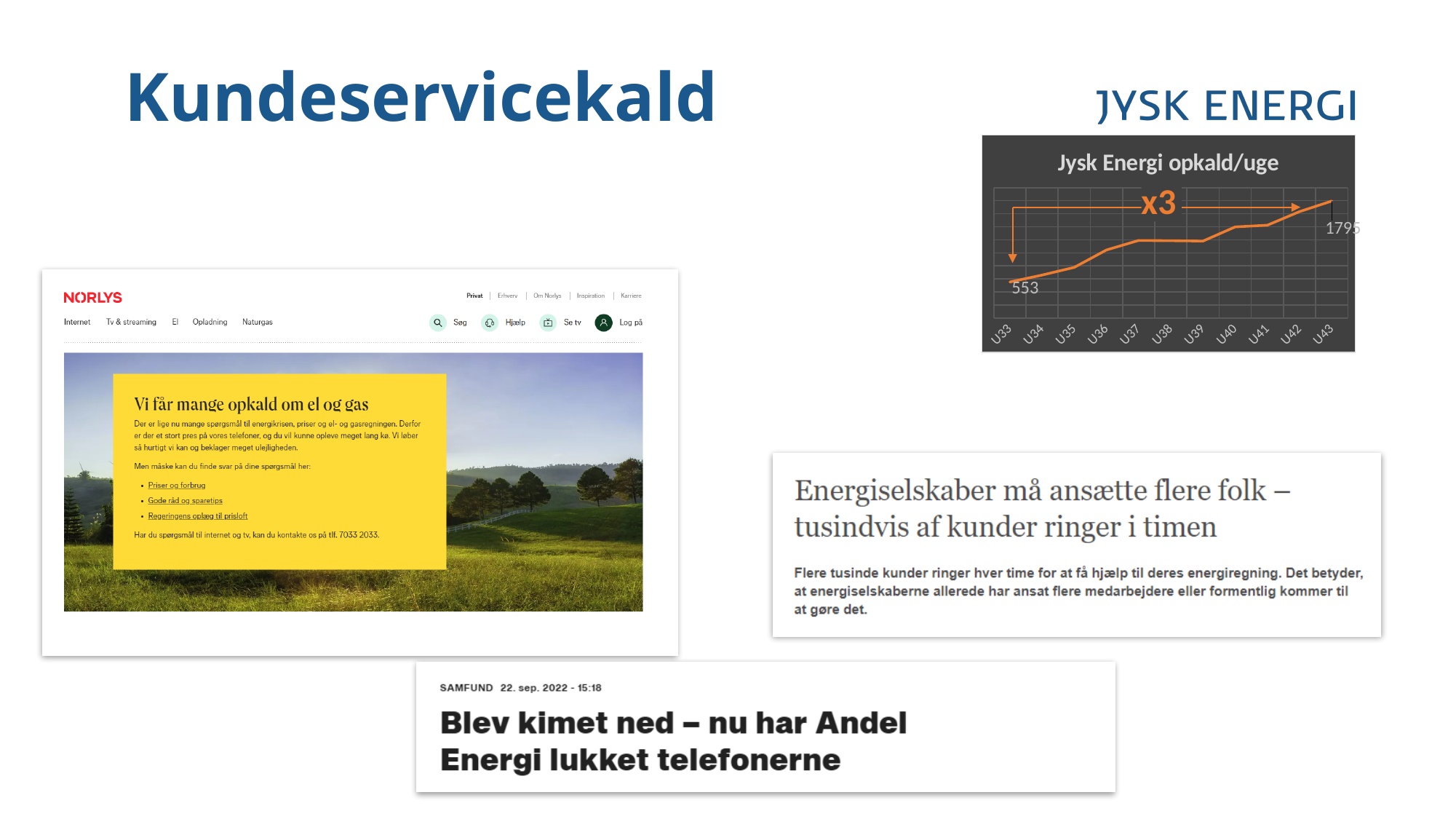
Which week has the highest value in the chart? U43 Do the values rise or fall from U33 to U43? rise How many weeks are shown on the x axis of the chart? 11 What kind of chart is shown under the title "Jysk Energi opkald/uge"? line chart Which is larger, the value for U43 or the value for U33? U43 What is the value for U33 in the chart? 553 What is the title of the chart? Jysk Energi opkald/uge Which week has the lowest value in the chart? U33 Which is larger, the value for U40 or the value for U34? U40 What is the value for U43 in the chart? 1795 What is the difference between the values for U43 and U33? 1242 What multiplier is annotated on the chart between U33 and U43? x3